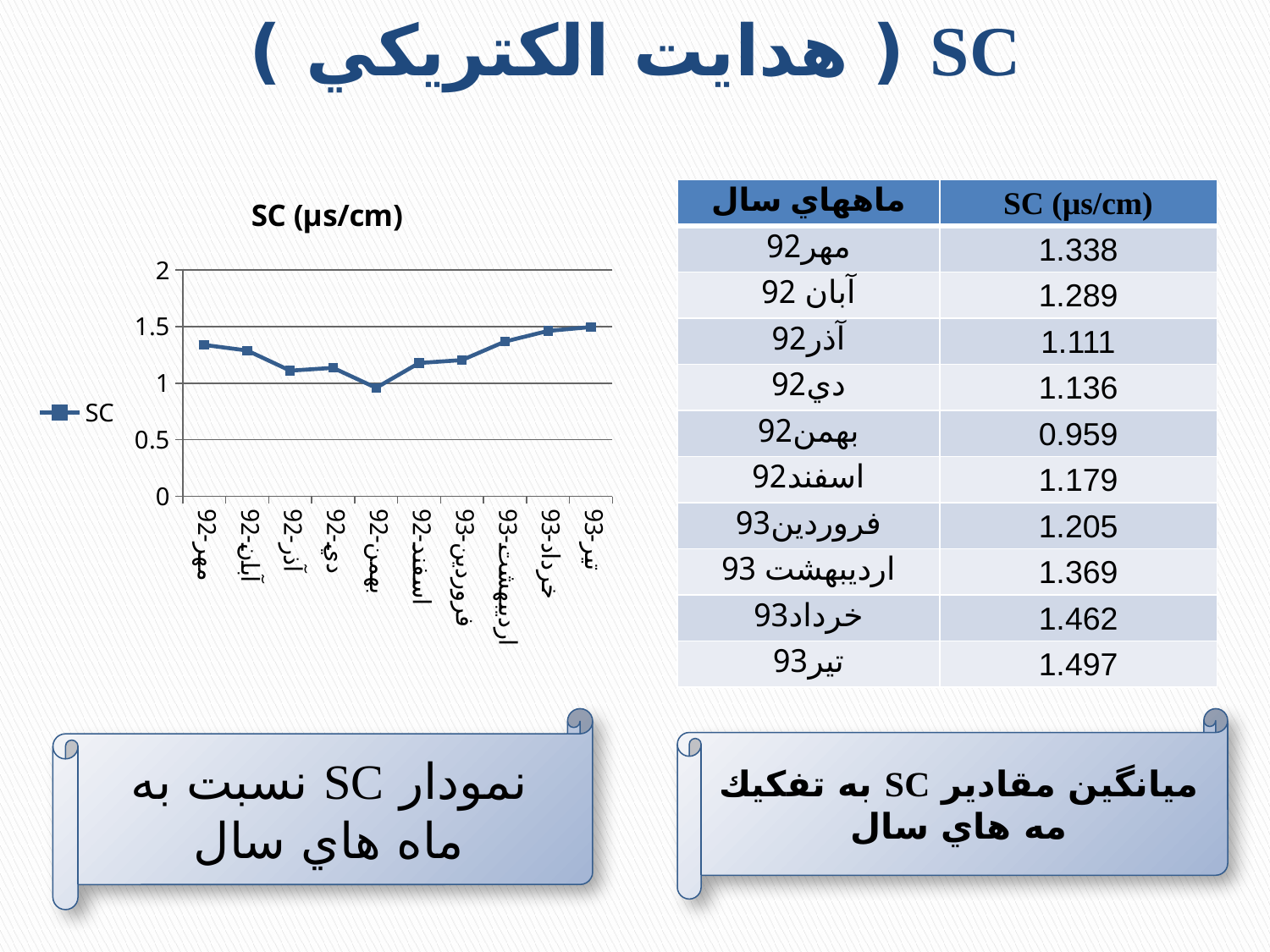
What is the SC value for بهمن92? 0.959 How many series does the chart legend list? 1 What is the SC value for آذر92? 1.111 What is the SC value for تير93? 1.497 Is the SC value for بهمن92 greater or less than 1? less How many months are plotted on the x axis of the chart? 10 Which month has the lowest SC value? بهمن92 What kind of chart is shown on the slide? line chart Which month has the highest SC value? تير93 Do the SC values rise or fall from بهمن92 to تير93? rise What is the title of the chart? SC (µs/cm) What is the difference between the SC values for تير93 and بهمن92? 0.538